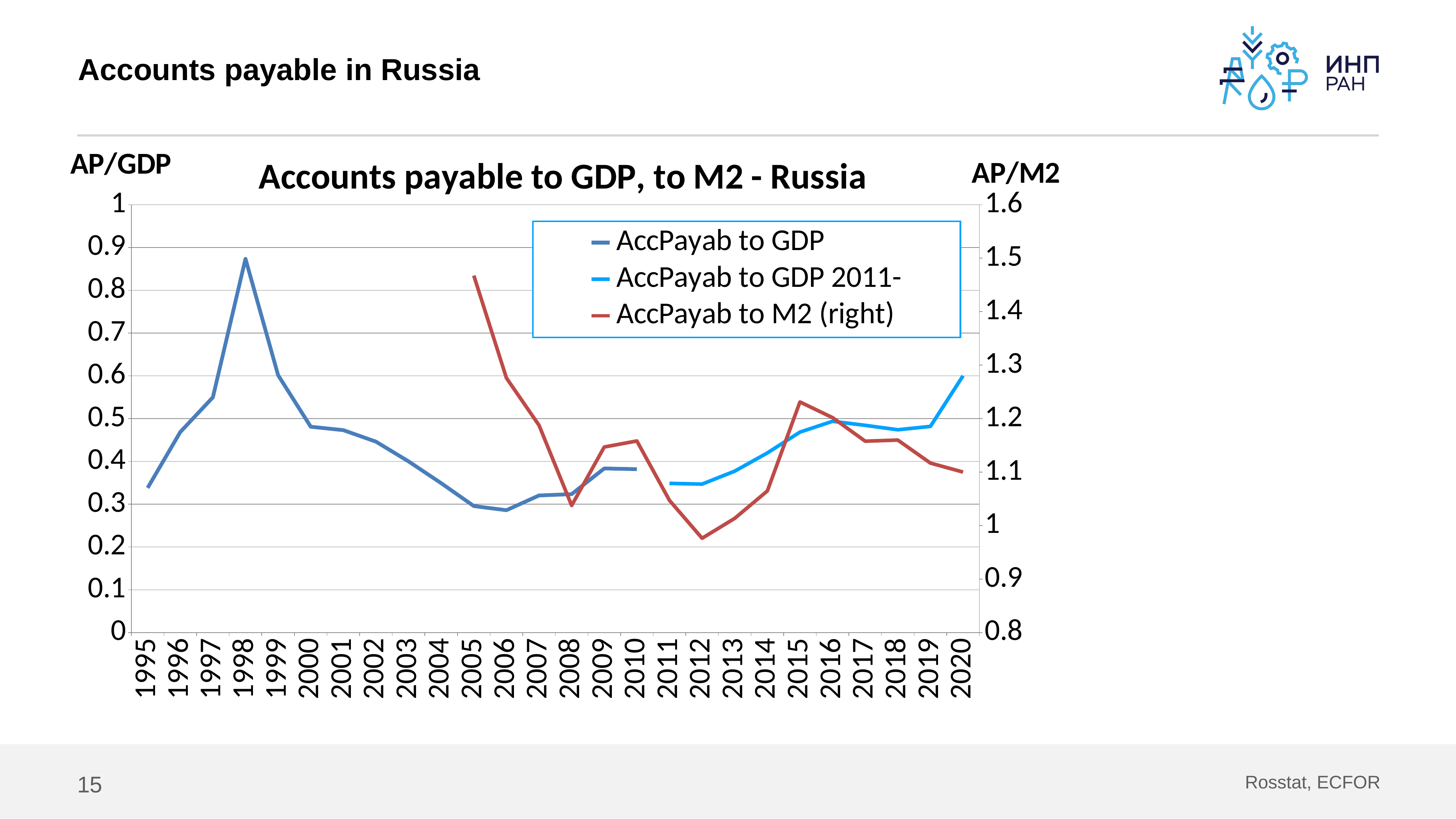
In which year does the AccPayab to M2 (right) series reach its lowest value? 2012 Is the AccPayab to GDP value for 1995 greater or less than 0.4? less Is the AccPayab to GDP value for 1998 greater or less than 0.8? greater What kind of chart is shown on the slide? Line chart In which year does the AccPayab to GDP 2011- series reach its highest value? 2020 How many series does the legend list? 3 How many years are shown on the x axis? 26 Which is larger, the AccPayab to GDP value for 1998 or for 1999? 1998 Is the AccPayab to M2 (right) value for 2005 greater or less than 1.4? greater In which year does the AccPayab to GDP series reach its highest value? 1998 What is the title of the chart? Accounts payable to GDP, to M2 - Russia Does the AccPayab to M2 (right) series rise or fall from 2005 to 2008? Fall